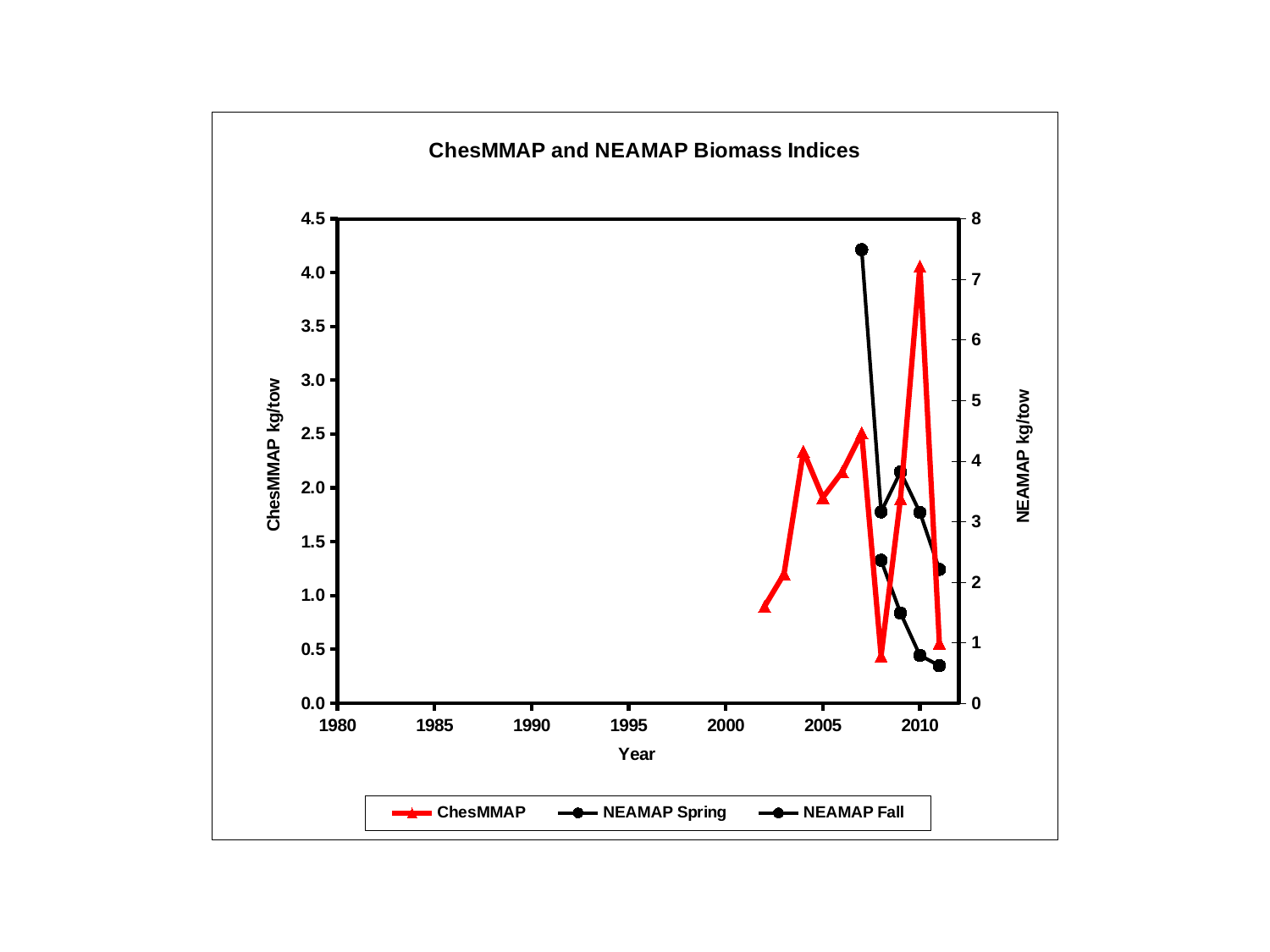
Which year has the larger ChesMMAP value, 2004 or 2005? 2004 Is the ChesMMAP value for 2010 greater or less than 3.5? greater What is the title of the chart? ChesMMAP and NEAMAP Biomass Indices In which year does the ChesMMAP series reach its highest value? 2010 What kind of chart is shown on the slide? line chart What is the label of the right-hand y axis? NEAMAP kg/tow Is the ChesMMAP value for 2008 greater or less than 1.0? less How many data points does the ChesMMAP series have? 10 Is the ChesMMAP value for 2004 greater or less than 2.0? greater How many series does the legend list? 3 Does the ChesMMAP series rise or fall from 2002 to 2004? rise In which year does the ChesMMAP series reach its lowest value? 2008